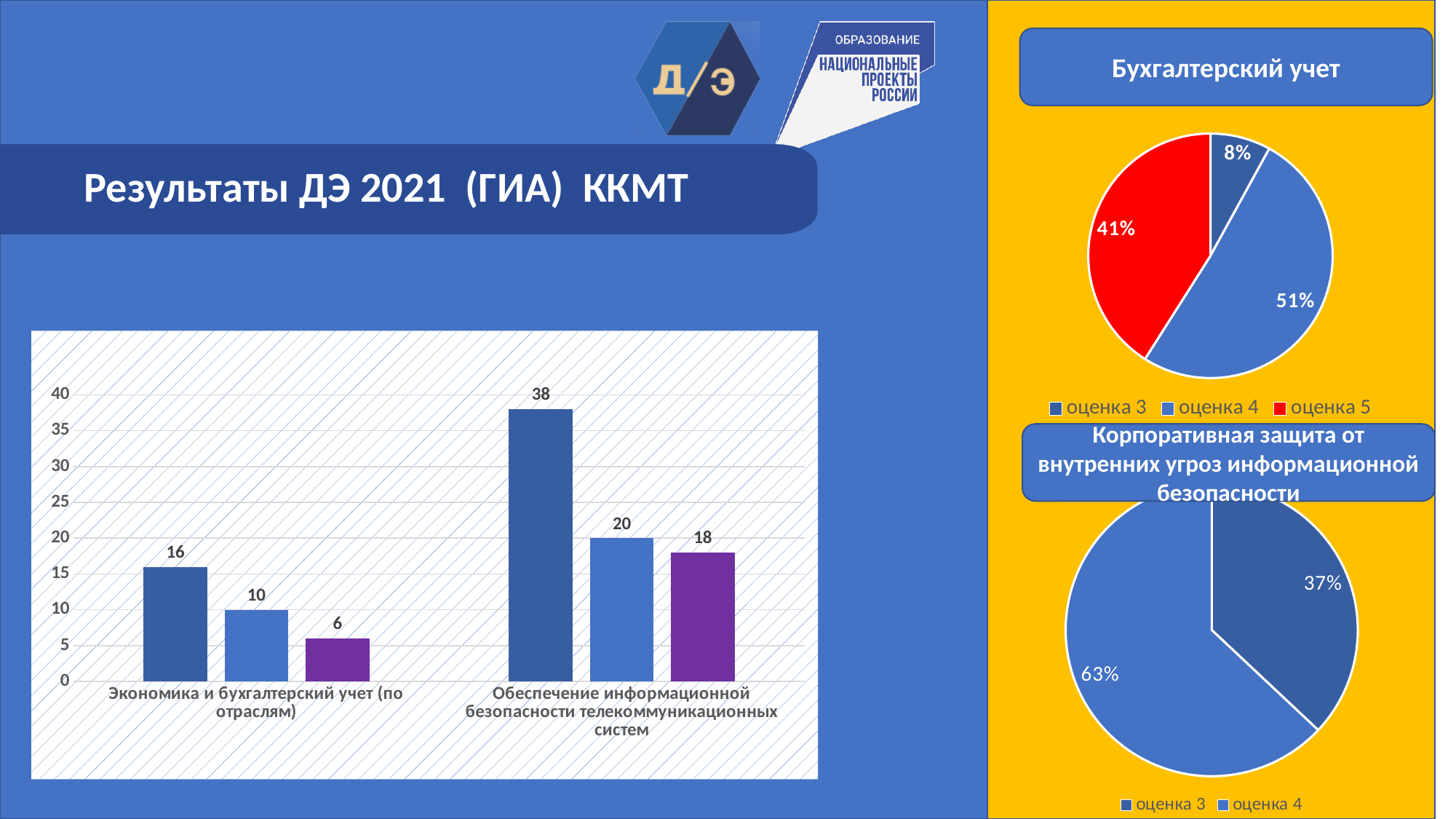
In the bar chart on the left, what is the difference between the highest bar for 'Обеспечение информационной безопасности телекоммуникационных систем' (38) and the highest bar for 'Экономика и бухгалтерский учет (по отраслям)' (16)? 22 In the bar chart on the left, what is the value of the first (dark blue) bar for 'Экономика и бухгалтерский учет (по отраслям)'? 16 In the pie chart 'Корпоративная защита от внутренних угроз информационной безопасности', what share does 'оценка 4' have? 63% In the pie chart 'Бухгалтерский учет', what share does 'оценка 5' have? 41% In the bar chart on the left, what is the value of the purple bar for 'Экономика и бухгалтерский учет (по отраслям)'? 6 In the pie chart 'Бухгалтерский учет', which grade has the smallest share? оценка 3 What type of chart is shown on the left of the slide? bar chart In the bar chart on the left, how many categories are shown on the x axis? 2 In the bar chart on the left, which category has the highest bar overall? Обеспечение информационной безопасности телекоммуникационных систем In the pie chart 'Корпоративная защита от внутренних угроз информационной безопасности', which is larger: 'оценка 3' or 'оценка 4'? оценка 4 How many entries does the legend of the pie chart 'Бухгалтерский учет' list? 3 In the bar chart on the left, what is the value of the tallest bar for 'Обеспечение информационной безопасности телекоммуникационных систем'? 38